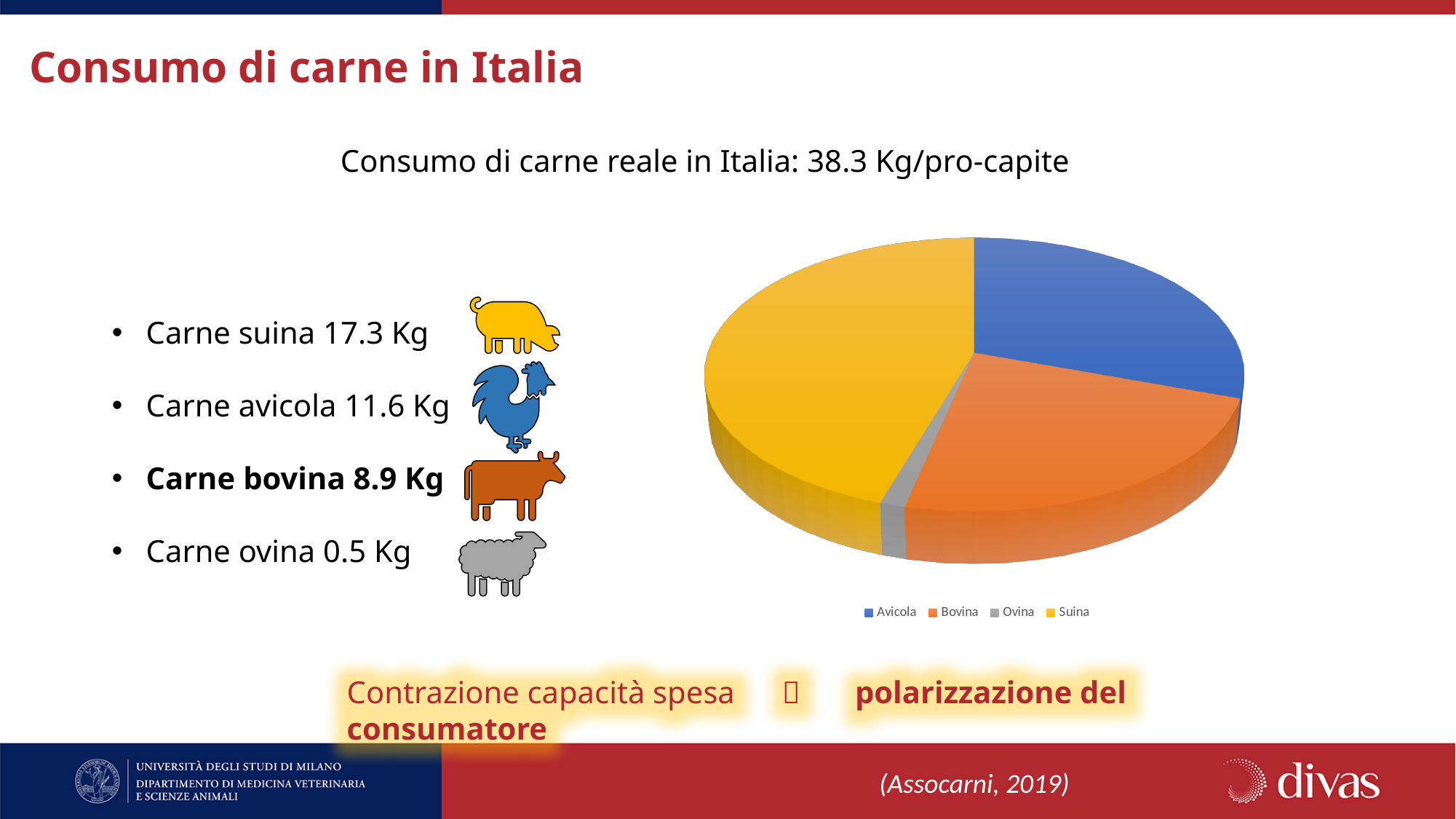
What kind of chart is shown on the slide? pie chart What is the consumption value for Carne suina? 17.3 Kg What is the consumption value for Carne ovina? 0.5 Kg What is the total real meat consumption per capita in Italy stated on the slide? 38.3 Kg/pro-capite What is the difference between the consumption of Carne suina and Carne avicola? 5.7 Kg What colour is the Suina slice in the pie chart? yellow Which category has the largest slice in the pie chart? Suina Which category has the smallest slice in the pie chart? Ovina How many entries does the legend of the pie chart list? 4 How many slices does the pie chart have? 4 Which slice is larger in the pie chart, Avicola or Bovina? Avicola What is the consumption value for Carne bovina? 8.9 Kg